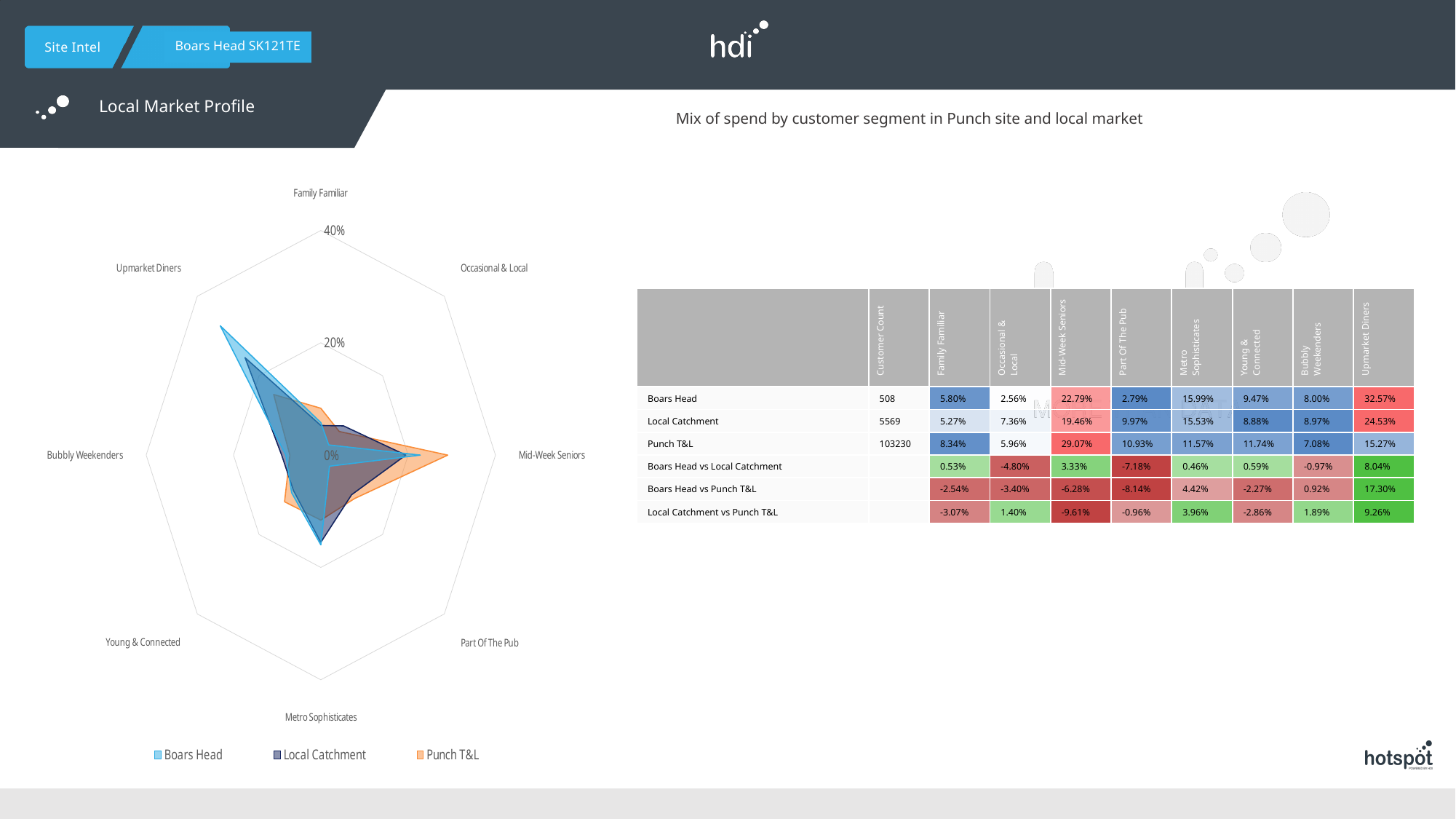
Is the Punch T&L value for Upmarket Diners greater or less than 20%? less Which customer segment has the lowest value for Boars Head? Occasional & Local Is the Boars Head value for Upmarket Diners greater or less than 20%? greater How many customer segments are plotted around the radar chart? 8 According to the table, what is the Punch T&L share for Mid-Week Seniors? 29.07% What is the highest percentage label shown on the radar chart's axis? 40% What type of chart is shown on the left of the slide? radar chart What is the difference between Boars Head and Local Catchment for Upmarket Diners, as shown in the table? 8.04% Which customer segment has the highest value for Boars Head? Upmarket Diners According to the table, what is the Boars Head share for Upmarket Diners? 32.57% For Mid-Week Seniors, which is larger: Punch T&L or Boars Head? Punch T&L How many series does the legend of the radar chart list? 3